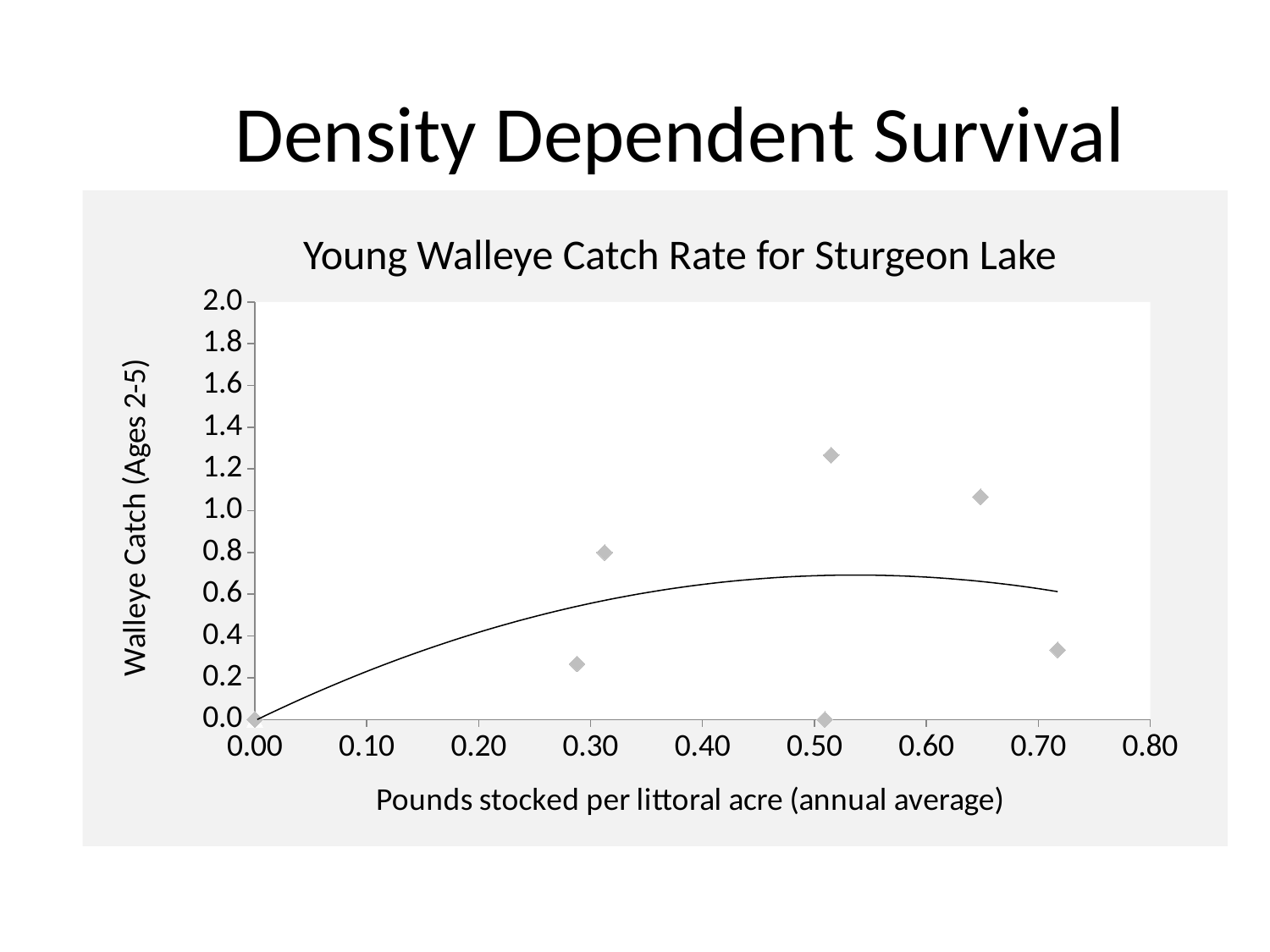
What kind of chart is shown on the slide? scatter chart How many data points have a walleye catch above 1.0? 2 Is the walleye catch for the point at about 0.65 pounds stocked per littoral acre greater or less than 1.0? greater Is the walleye catch for the point at about 0.31 pounds stocked per littoral acre greater or less than 0.6? greater Does the fitted curve rise or fall as pounds stocked increases from 0.00 to 0.40? rise Is the highest walleye catch value plotted greater or less than 1.2? greater What is the title of the chart? Young Walleye Catch Rate for Sturgeon Lake Which has the higher walleye catch: the point at about 0.51 pounds stocked near the top of the chart or the point at about 0.65 pounds stocked? the point at about 0.51 What is the maximum value shown on the y axis? 2.0 What is the label of the x axis? Pounds stocked per littoral acre (annual average)